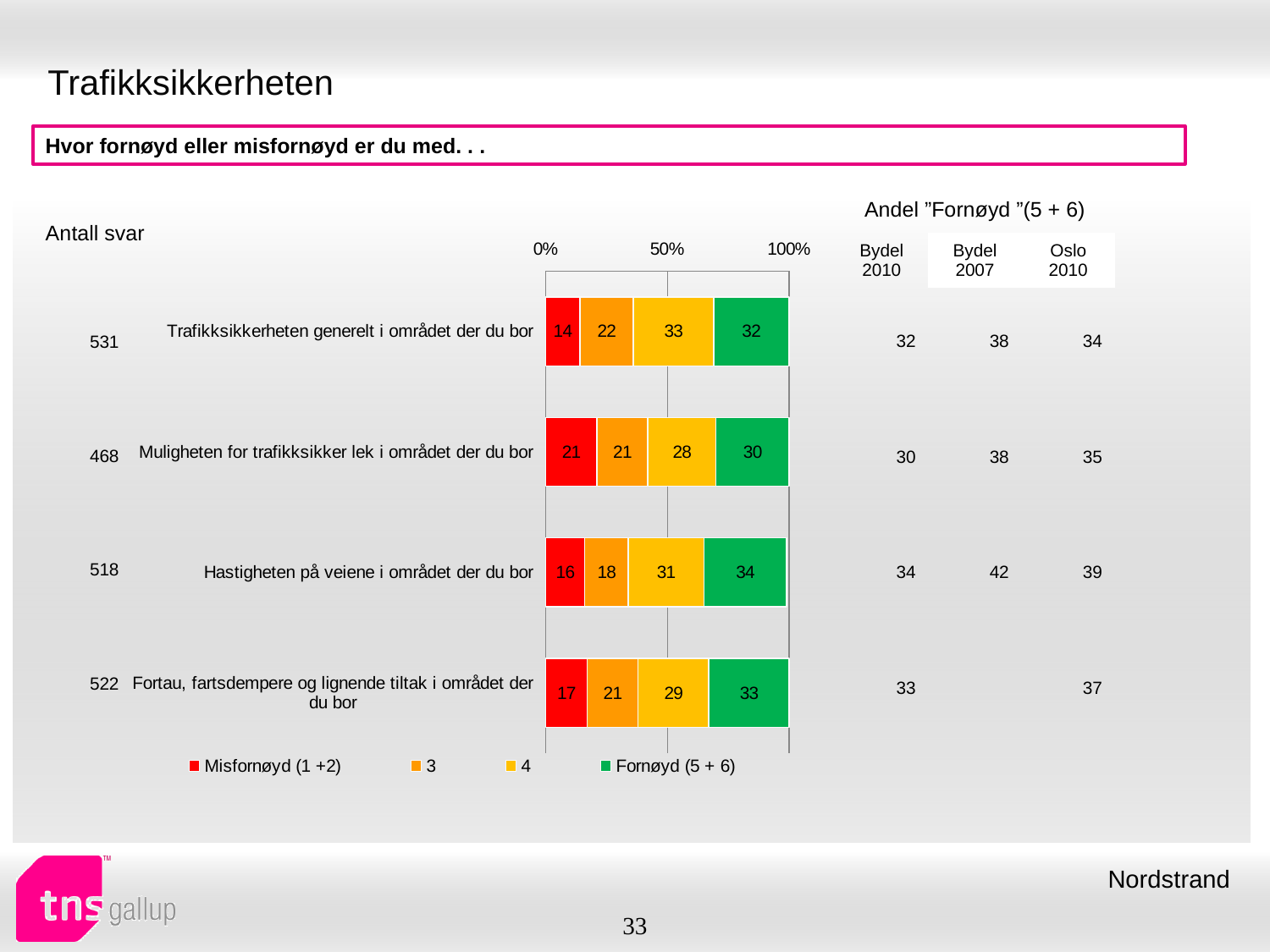
Which category has the lowest Misfornøyd (1 +2) value? Trafikksikkerheten generelt i området der du bor Which is larger: the Misfornøyd (1 +2) value for "Fortau, fartsdempere og lignende tiltak i området der du bor" or for "Trafikksikkerheten generelt i området der du bor"? Fortau, fartsdempere og lignende tiltak i området der du bor How many categories (questions) are plotted in the chart? 4 Which category has the highest Fornøyd (5 + 6) value? Hastigheten på veiene i området der du bor What is the Fornøyd (5 + 6) value for "Trafikksikkerheten generelt i området der du bor"? 32 How many series does the chart legend list? 4 What is the difference between the Fornøyd (5 + 6) value for "Hastigheten på veiene i området der du bor" and for "Muligheten for trafikksikker lek i området der du bor"? 4 What is the total of the stacked bar for "Muligheten for trafikksikker lek i området der du bor"? 100 What is the Misfornøyd (1 +2) value for "Muligheten for trafikksikker lek i området der du bor"? 21 What kind of chart is shown on the slide? stacked bar chart What is the value of series "4" for "Hastigheten på veiene i området der du bor"? 31 Which colour represents the Fornøyd (5 + 6) series in the chart? green